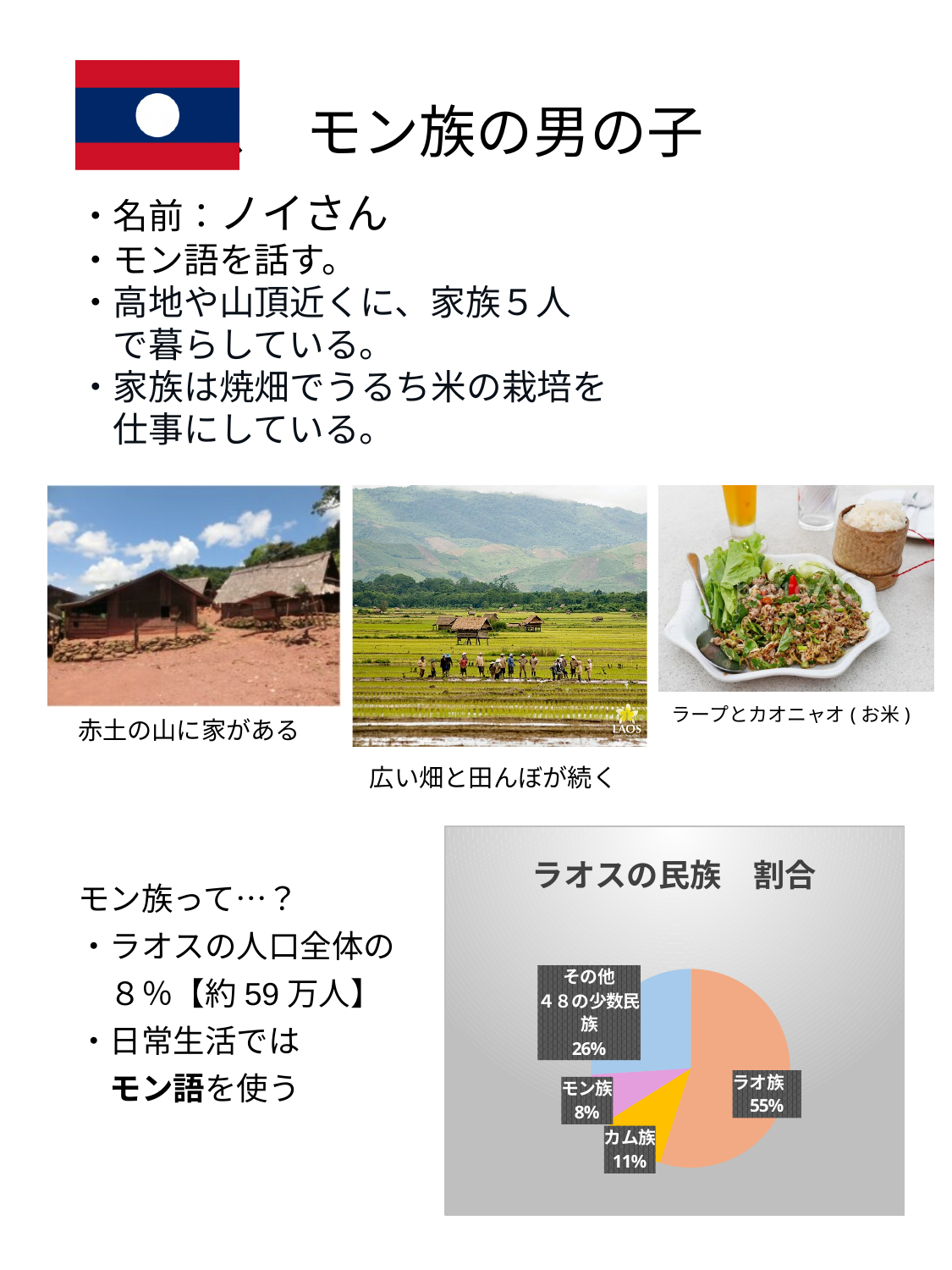
Which is larger, the share for カム族 or the share for モン族? カム族 Which slice of the pie is the largest? ラオ族 What is the title of the chart? ラオスの民族 割合 What share of the pie does モン族 have? 8% What share of the pie does ラオ族 have? 55% What share of the pie does その他４８の少数民族 have? 26% What is the difference in percentage points between ラオ族 and その他４８の少数民族? 29 What is the difference in percentage points between カム族 and モン族? 3 How many slices does the pie chart have? 4 What type of chart is shown on the slide? pie chart Which slice of the pie is the smallest? モン族